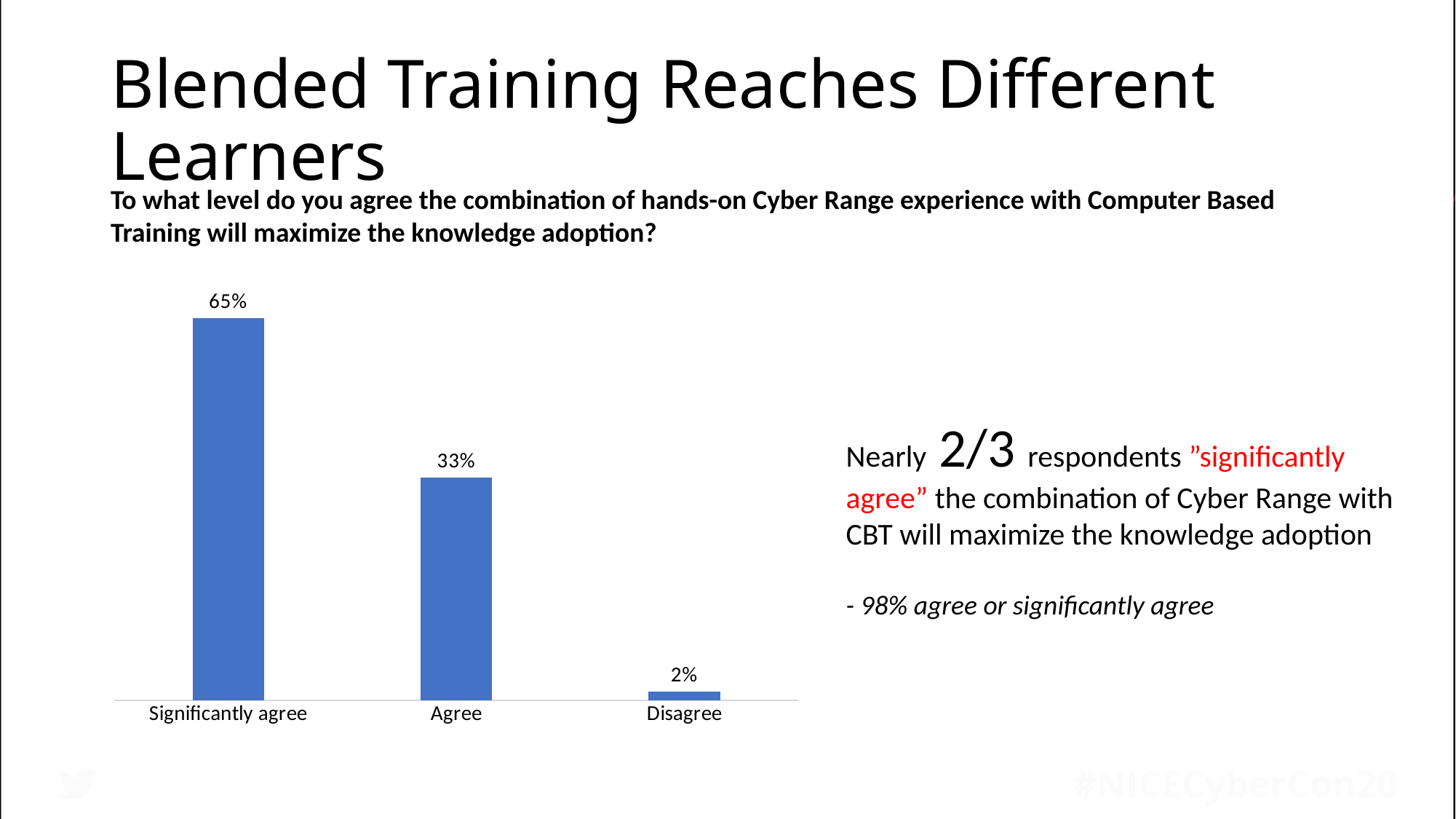
What kind of chart is shown on the slide? Bar chart What percentage of respondents answered "Significantly agree"? 65% What colour are the bars in the chart? Blue What percentage of respondents answered "Agree"? 33% How many response categories are shown in the chart? 3 Which response category has the highest percentage? Significantly agree What is the difference in percentage points between "Agree" and "Disagree"? 31 Which response category has the lowest percentage? Disagree What is the difference in percentage points between "Significantly agree" and "Agree"? 32 Which is larger, the value for "Agree" or the value for "Disagree"? Agree What percentage of respondents answered "Disagree"? 2% Do the values rise or fall moving from left to right across the categories? Fall